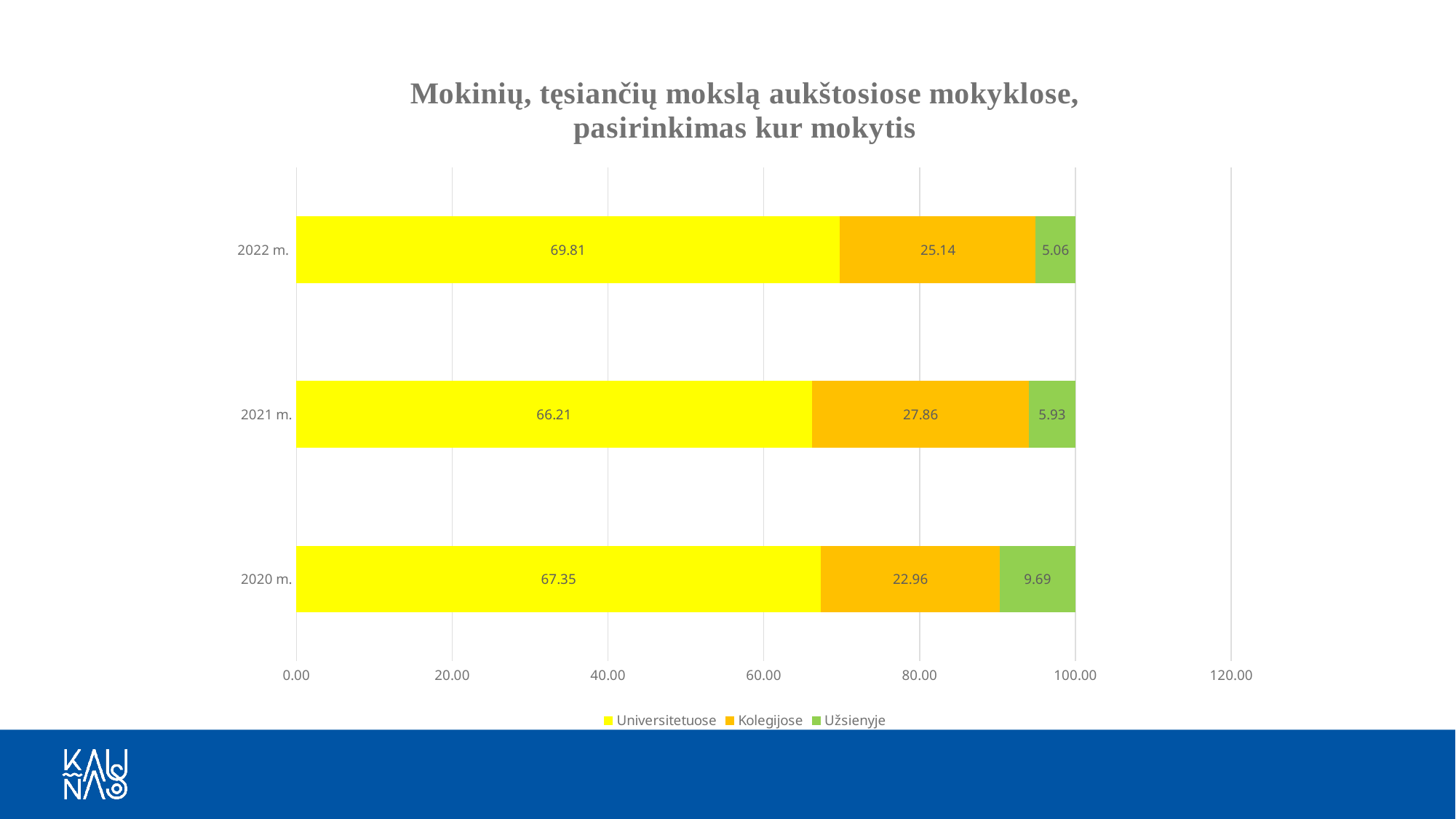
What kind of chart is shown on the slide? Stacked bar chart What is the Universitetuose value for 2022 m.? 69.81 What is the Užsienyje value for 2020 m.? 9.69 What is the total of the stacked bar for 2021 m.? 100.00 In which year is the Universitetuose value highest? 2022 m. What is the difference between the Užsienyje values for 2020 m. and 2022 m.? 4.63 What is the difference between the Kolegijose values for 2021 m. and 2020 m.? 4.90 How many series does the legend list? 3 In which year is the Kolegijose value lowest? 2020 m. What is the Kolegijose value for 2021 m.? 27.86 Which is larger: the Universitetuose value for 2021 m. or for 2020 m.? 2020 m. How many years (categories) are shown on the chart? 3